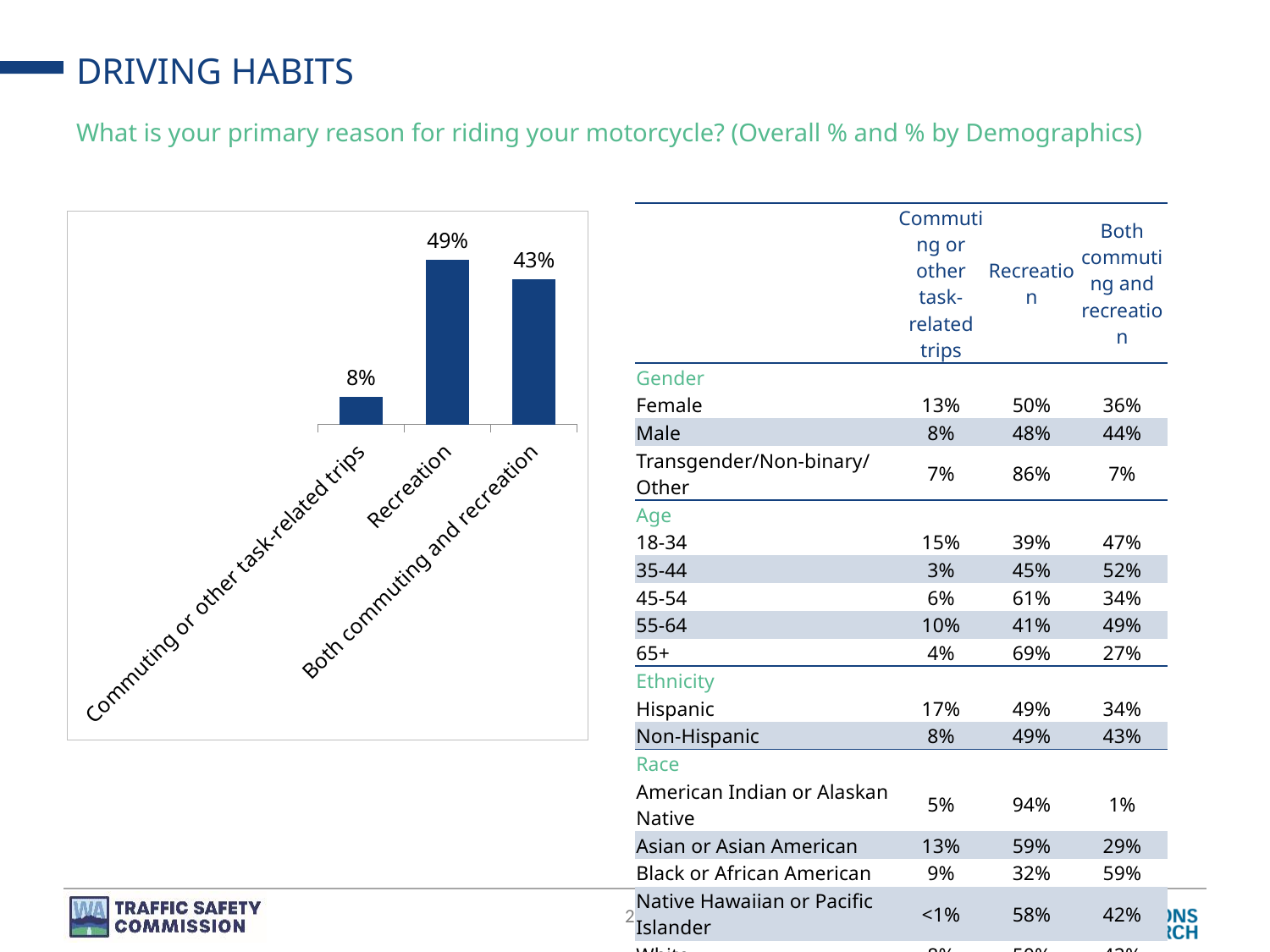
Which category has the lowest value in the bar chart? Commuting or other task-related trips What type of chart is shown on the slide? Bar chart What is the total of the three values shown in the bar chart? 100% What is the difference between the values for Recreation and Commuting or other task-related trips? 41% How many categories are shown in the bar chart? 3 Which category has the highest value in the bar chart? Recreation What is the value shown for Commuting or other task-related trips? 8% What is the value shown for Both commuting and recreation? 43% What is the difference between the values for Recreation and Both commuting and recreation? 6% Which is larger, the value for Commuting or other task-related trips or the value for Both commuting and recreation? Both commuting and recreation What percentage of respondents said their primary reason for riding is Recreation? 49% Which is larger, the value for Recreation or the value for Both commuting and recreation? Recreation